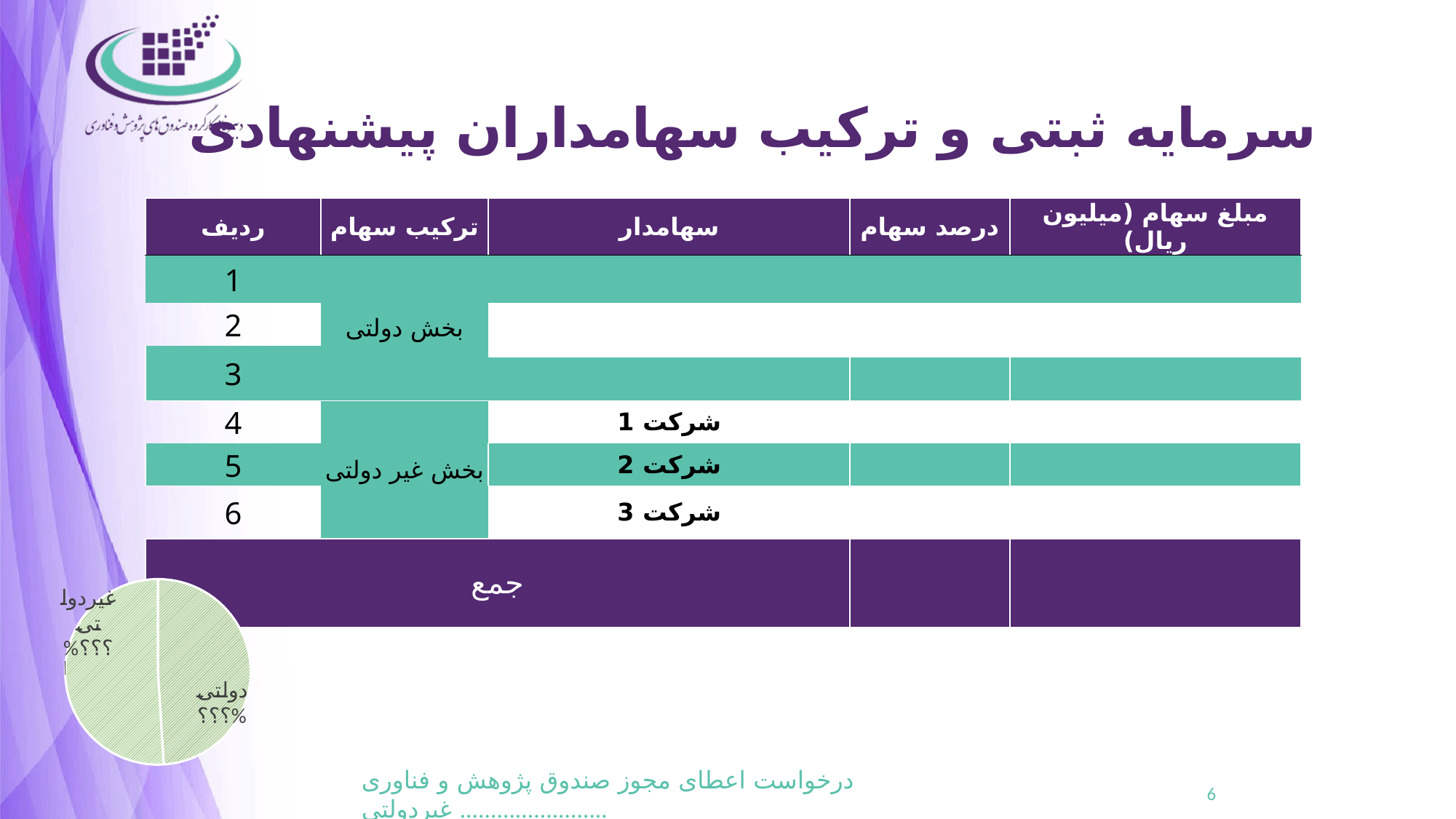
What are the two categories labelled on the pie chart at the bottom left of the slide? دولتی and غیردولتی What percentage text is printed on the غیردولتی slice of the pie chart? ???% What kind of chart is shown at the bottom left of the slide? pie chart What percentage text is printed on the دولتی slice of the pie chart? ???% How many slices does the pie chart at the bottom left of the slide have? 2 Does the pie chart at the bottom left of the slide show actual numeric percentages for its slices? No, both show ???%